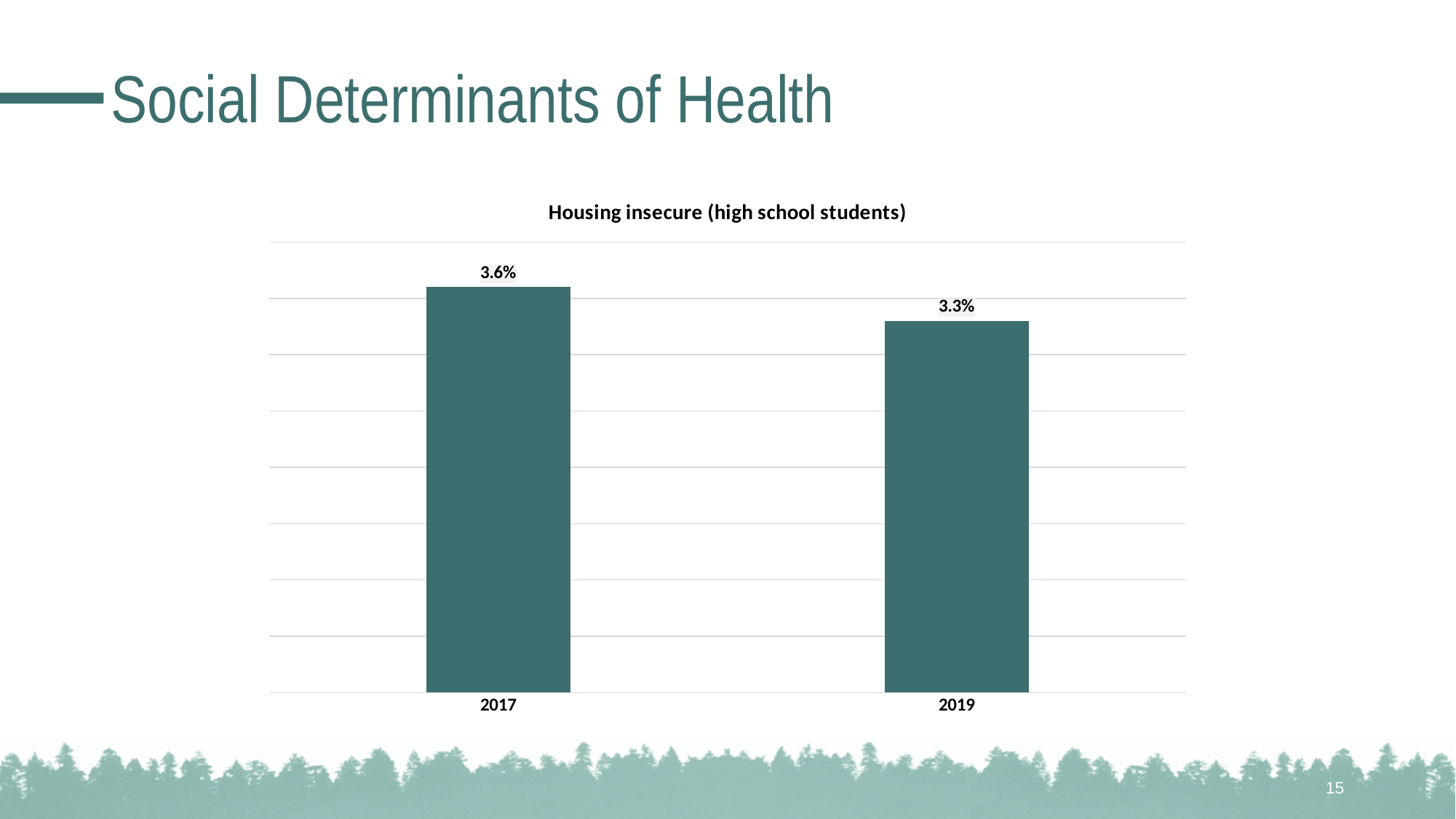
Do the values rise or fall from 2017 to 2019? fall What is the title of the chart? Housing insecure (high school students) What kind of chart is shown? bar chart Which is larger, the value for 2017 or the value for 2019? 2017 How many years are shown on the chart? 2 Which year has the lowest value? 2019 What is the value for 2019? 3.3% What is the value for 2017? 3.6% Which year has the highest value? 2017 What colour are the bars in the chart? dark teal What is the difference between the 2017 and 2019 values? 0.3%